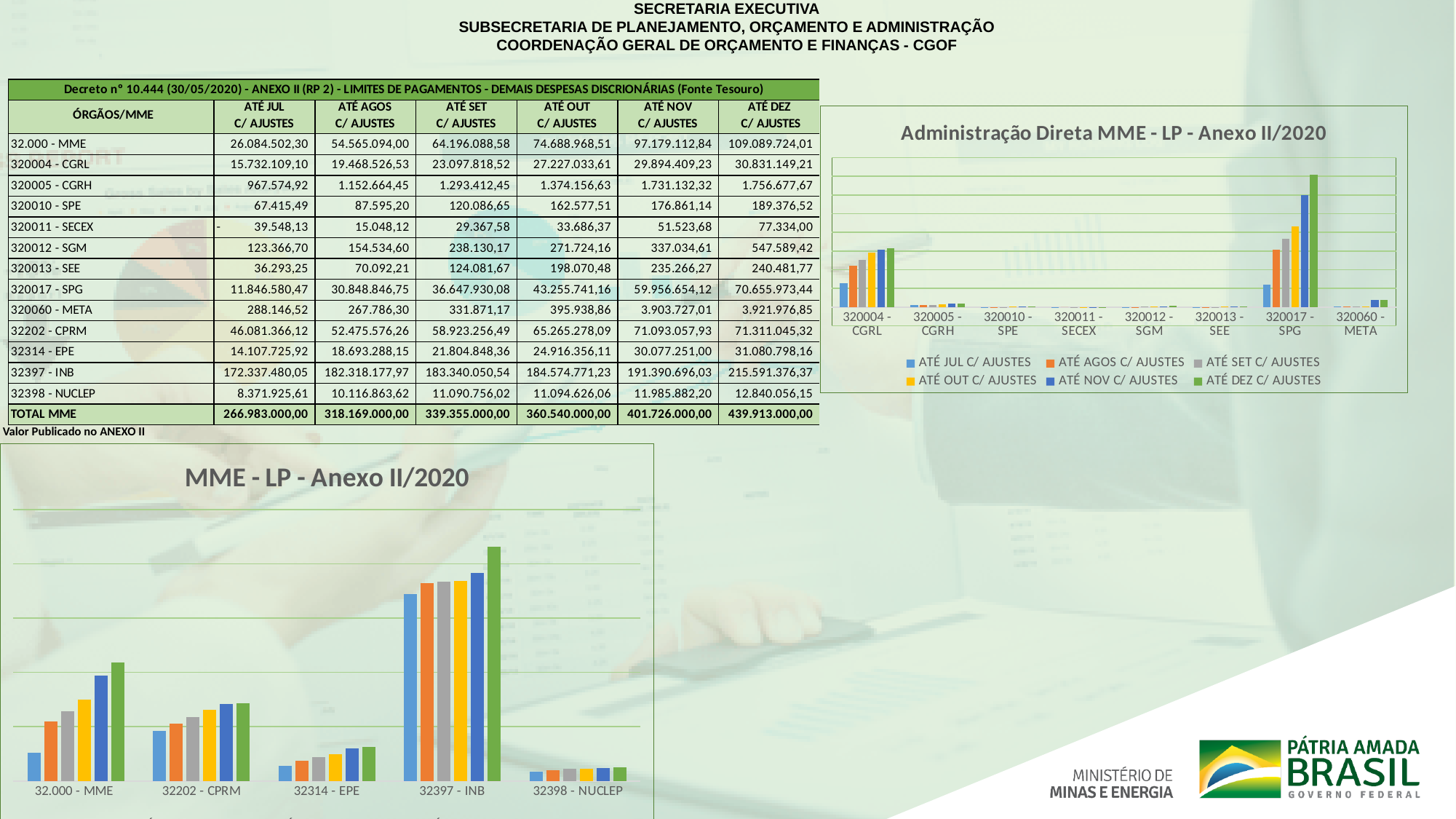
In the 'MME - LP - Anexo II/2020' chart, which category has the tallest bars? 32397 - INB What kind of chart is the 'Administração Direta MME - LP - Anexo II/2020' chart? bar chart What kind of chart is the 'MME - LP - Anexo II/2020' chart? bar chart In the 'Administração Direta MME - LP - Anexo II/2020' chart, which has the larger ATÉ DEZ C/ AJUSTES bar: 320004 - CGRL or 320017 - SPG? 320017 - SPG How many categories are shown on the x axis of the 'MME - LP - Anexo II/2020' chart? 5 How many series does the legend of the 'Administração Direta MME - LP - Anexo II/2020' chart list? 6 In the 'Administração Direta MME - LP - Anexo II/2020' chart, which category has the tallest bars? 320017 - SPG How many categories are shown on the x axis of the 'Administração Direta MME - LP - Anexo II/2020' chart? 8 In the 'Administração Direta MME - LP - Anexo II/2020' chart, do the bars for 320017 - SPG rise or fall from ATÉ JUL to ATÉ DEZ? rise In the 'MME - LP - Anexo II/2020' chart, which category has the shortest bars? 32398 - NUCLEP In the 'MME - LP - Anexo II/2020' chart, which has the larger ATÉ DEZ C/ AJUSTES bar: 32.000 - MME or 32202 - CPRM? 32.000 - MME In the 'Administração Direta MME - LP - Anexo II/2020' chart, what colour represents the ATÉ DEZ C/ AJUSTES series? green